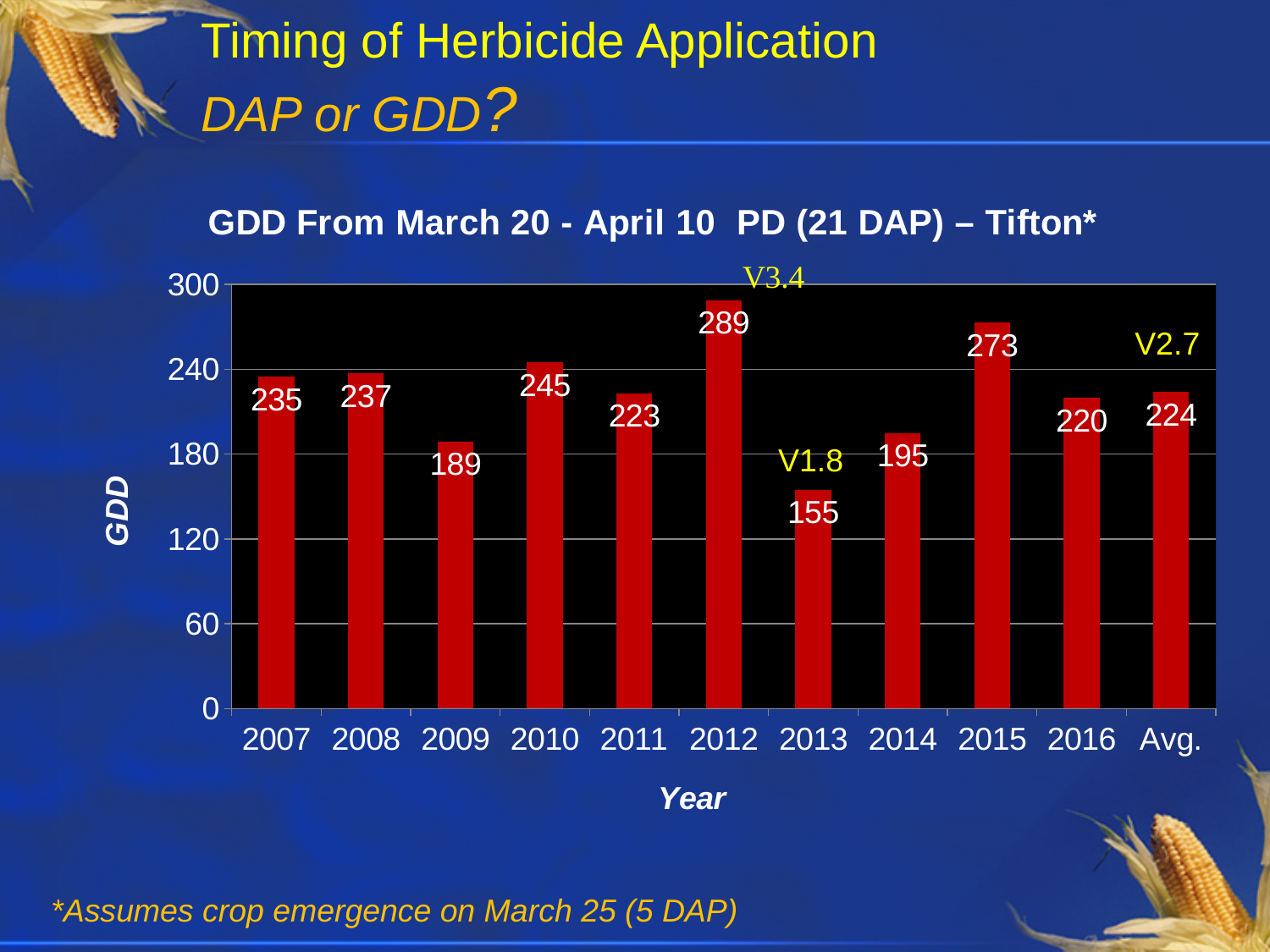
What is the label on the y-axis of the chart? GDD What is the difference between the GDD values for 2012 and 2013? 134 Which has a larger GDD value, 2015 or 2016? 2015 What is the title of the chart? GDD From March 20 - April 10 PD (21 DAP) – Tifton* What is the GDD value for 2013? 155 What is the GDD value shown for Avg.? 224 How many bars are shown in the chart? 11 Is the GDD value for 2009 greater or less than 180? greater Which year has the lowest GDD value? 2013 What type of chart is shown on the slide? Bar chart Which year has the highest GDD value? 2012 What is the GDD value for 2012? 289